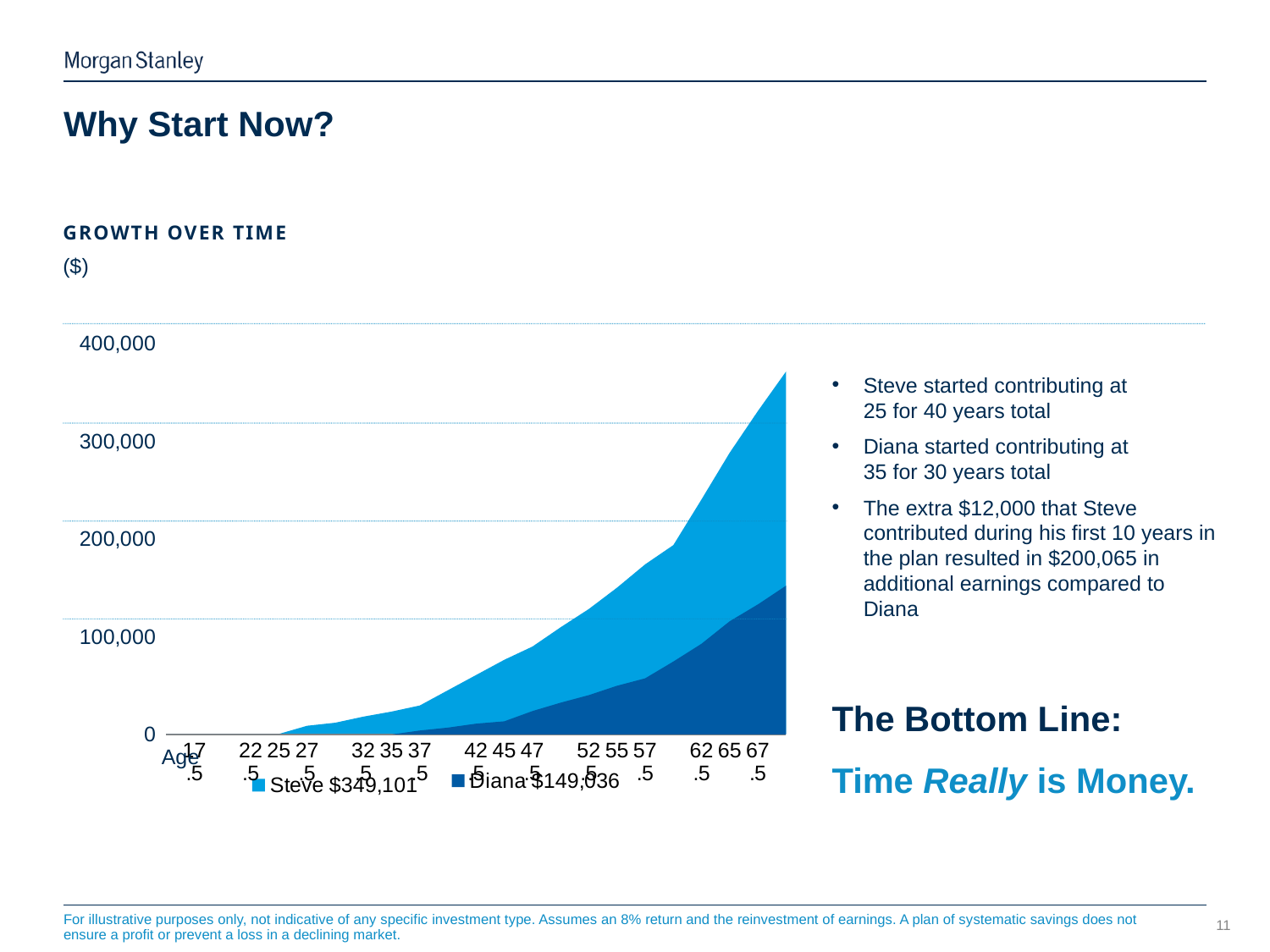
What is the difference between Steve's and Diana's final values shown in the legend? $200,065 Which series reaches the higher value at the right end of the chart, Steve or Diana? Steve Do the values rise or fall as age increases along the x axis? rise Is the value for Steve at age 67.5 greater or less than 300,000? greater What kind of chart is shown on the slide? area chart What final value is shown for Diana in the chart legend? $149,036 What final value is shown for Steve in the chart legend? $349,101 Is the value for Steve at age 47.5 greater or less than 200,000? less Is the value for Diana at age 67.5 greater or less than 200,000? less What is the highest value labelled on the y axis? 400,000 How many series does the chart legend list? 2 What is the title of the chart? GROWTH OVER TIME